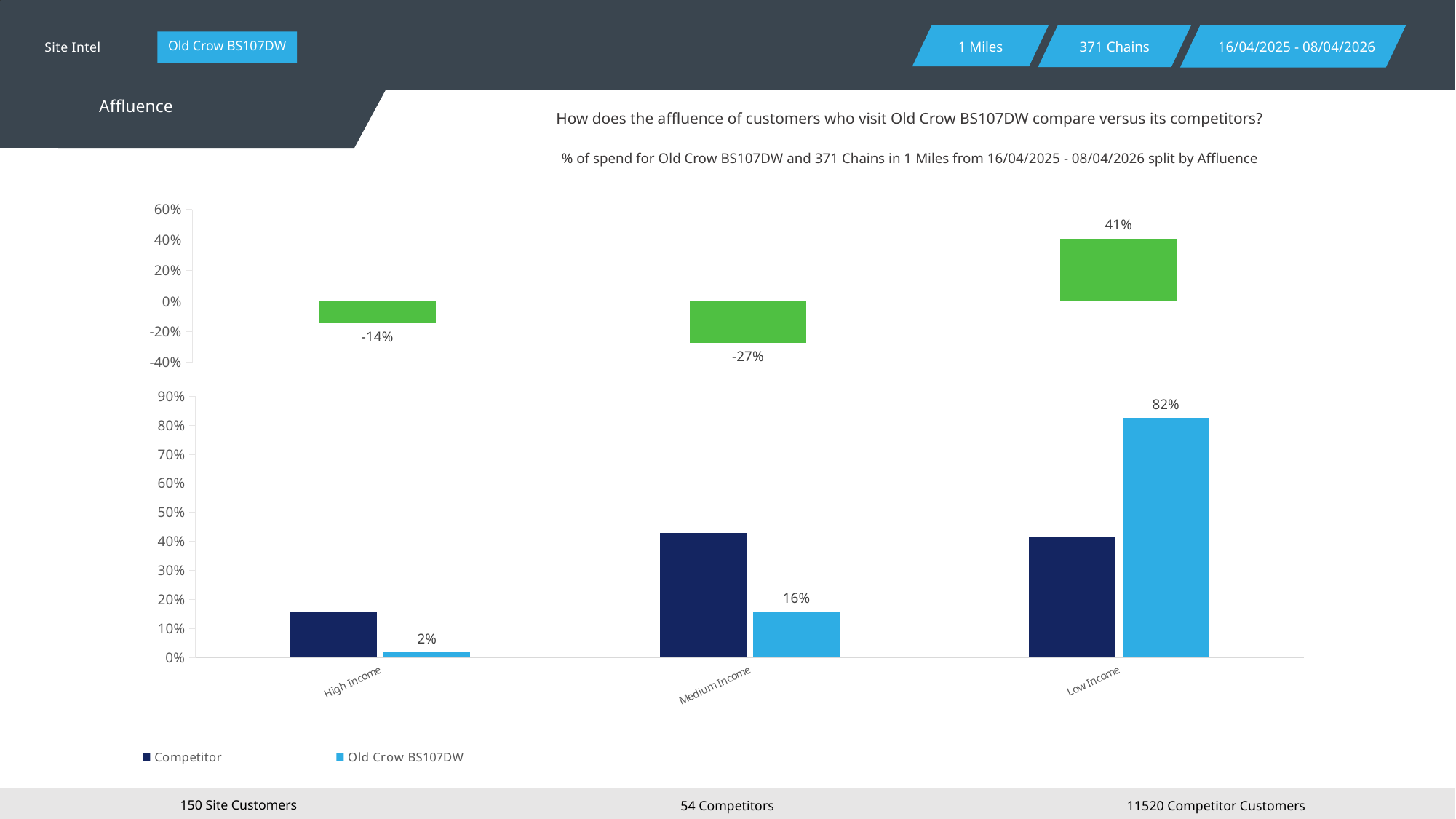
In the bottom chart, is the Competitor value for Medium Income greater or less than 30%? greater How many series does the legend of the bottom chart list? 2 In the bottom chart, is the Competitor value for High Income greater or less than 20%? less In the bottom chart, what is the value for Old Crow BS107DW in the High Income category? 2% In the bottom chart, what is the difference between the Old Crow BS107DW values for Low Income and Medium Income? 66% In the bottom chart, what is the value for Old Crow BS107DW in the Low Income category? 82% In the top chart, what is the value shown for the Medium Income category? -27% In the bottom chart, which category has the highest value for Old Crow BS107DW? Low Income In the top chart, what is the value shown for the Low Income category? 41% In the bottom chart, what is the value for Old Crow BS107DW in the Medium Income category? 16% In the top chart, which category has the lowest value? Medium Income What kind of chart is the bottom chart? Bar chart